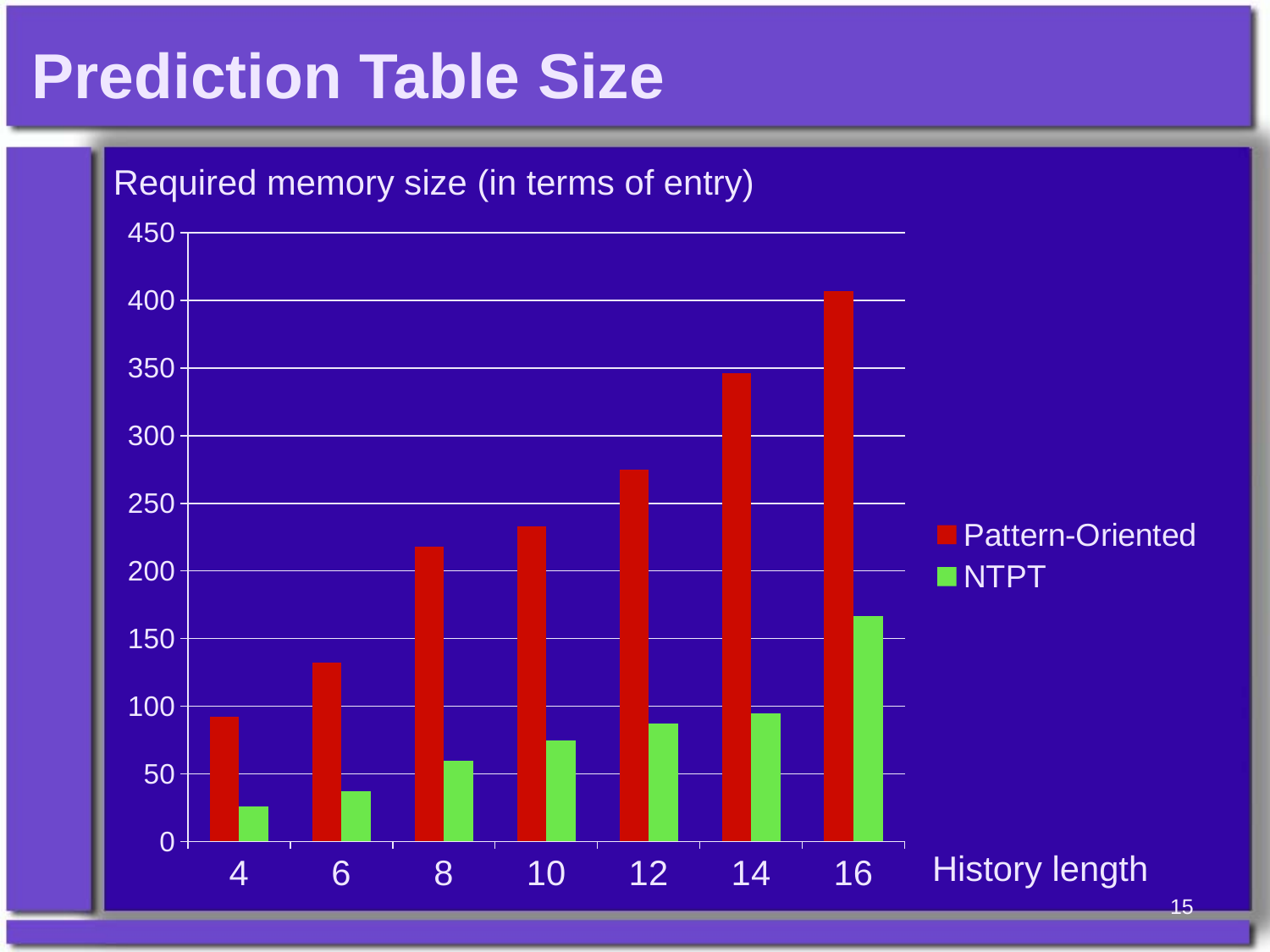
At which history length is the Pattern-Oriented value highest? 16 Is the Pattern-Oriented value at history length 14 greater or less than 300? greater How many series does the legend list? 2 Is the NTPT value at history length 16 greater or less than 150? greater Is the Pattern-Oriented value at history length 4 greater or less than 100? less At history length 10, which series has the larger value, Pattern-Oriented or NTPT? Pattern-Oriented What kind of chart is shown on the slide? bar chart At which history length is the NTPT value lowest? 4 What is the label of the x axis? History length Do the Pattern-Oriented values rise or fall as history length increases from 4 to 16? rise How many history length categories are plotted on the x axis? 7